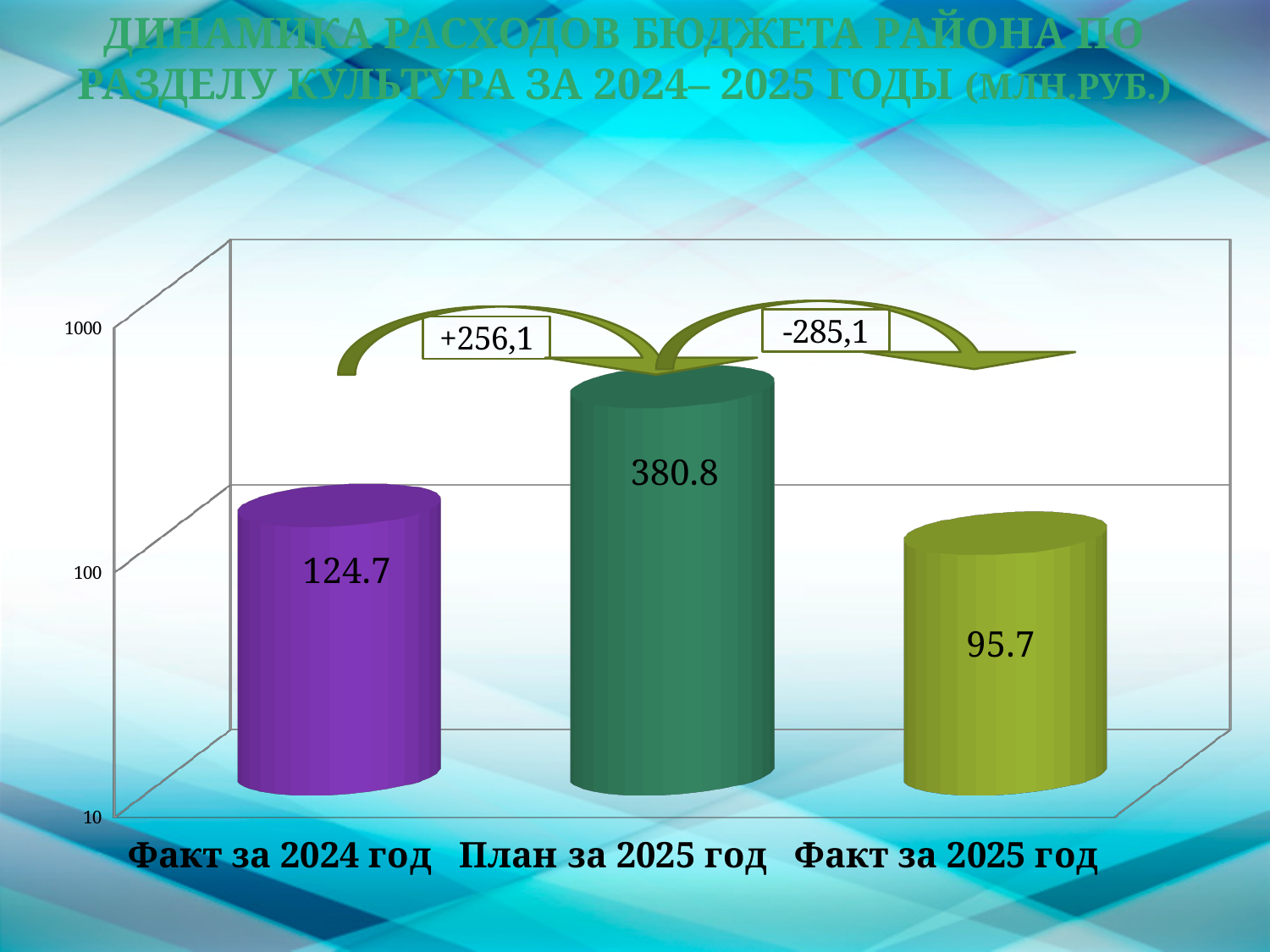
Which is larger, Факт за 2024 год or Факт за 2025 год? Факт за 2024 год What is the value for Факт за 2024 год? 124.7 What is the value for План за 2025 год? 380.8 Is the value for Факт за 2025 год greater or less than 100? less What change is shown on the arrow between План за 2025 год and Факт за 2025 год? -285,1 Which category has the highest value? План за 2025 год What kind of chart is shown on the slide? bar chart What is the difference between План за 2025 год and Факт за 2024 год? 256.1 What is the value for Факт за 2025 год? 95.7 How many categories are shown on the chart? 3 Which category has the lowest value? Факт за 2025 год What is the difference between План за 2025 год and Факт за 2025 год? 285.1